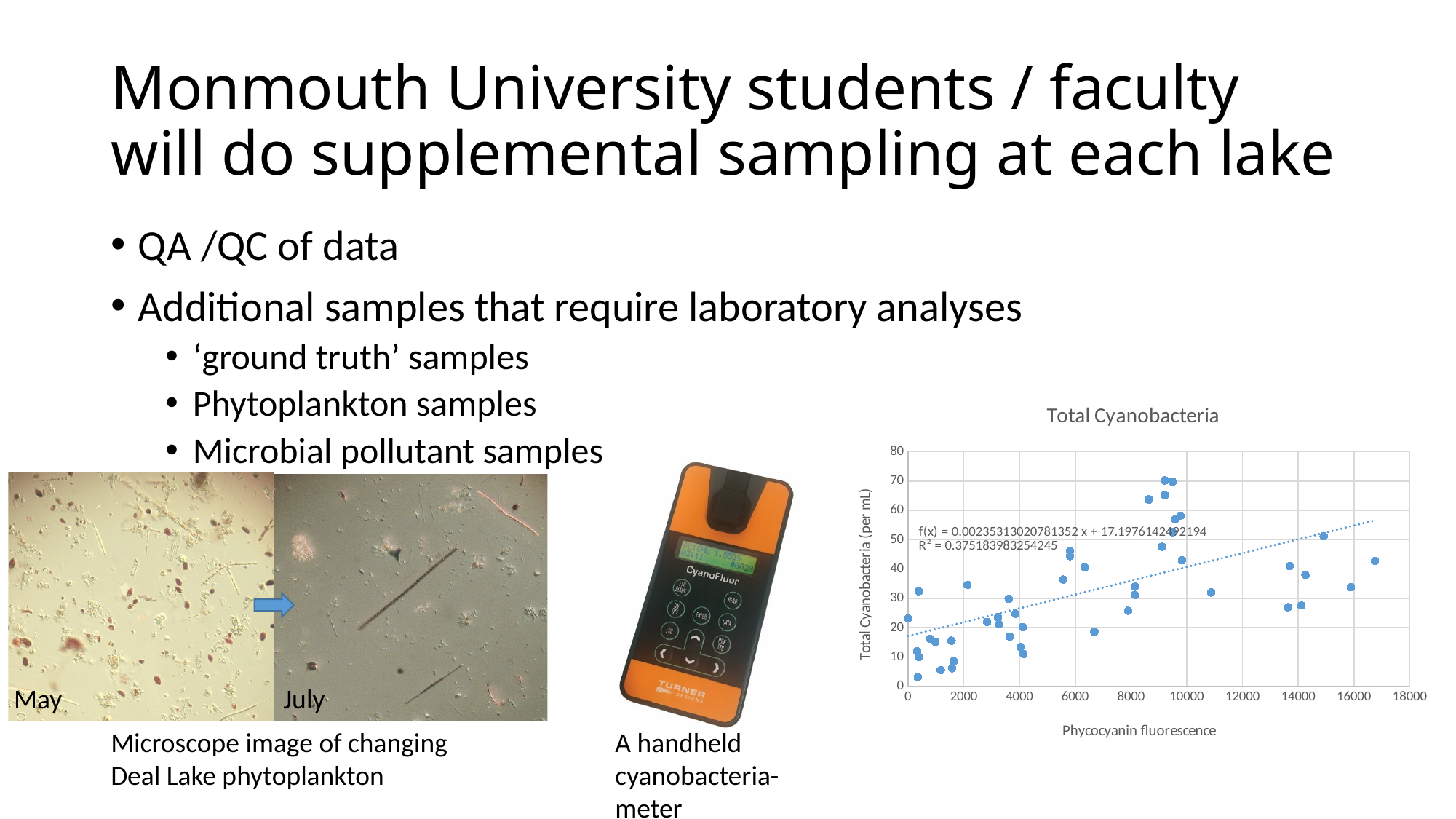
What is the slope of the trendline equation printed on the chart? 0.00235313020781352 Is the highest plotted Total Cyanobacteria value greater or less than 60? greater Is the lowest plotted Total Cyanobacteria value greater or less than 10? less What is the intercept of the trendline equation printed on the chart? 17.1976142492194 What is the largest tick value shown on the y axis? 80 What kind of chart is shown on the slide? scatter chart Is the highest plotted Total Cyanobacteria value greater or less than 80? less What is the largest tick value shown on the x axis? 18000 What is the R² value printed on the chart? 0.375183983254245 What is the title of the chart? Total Cyanobacteria Does the dotted trendline rise or fall as Phycocyanin fluorescence increases? rises